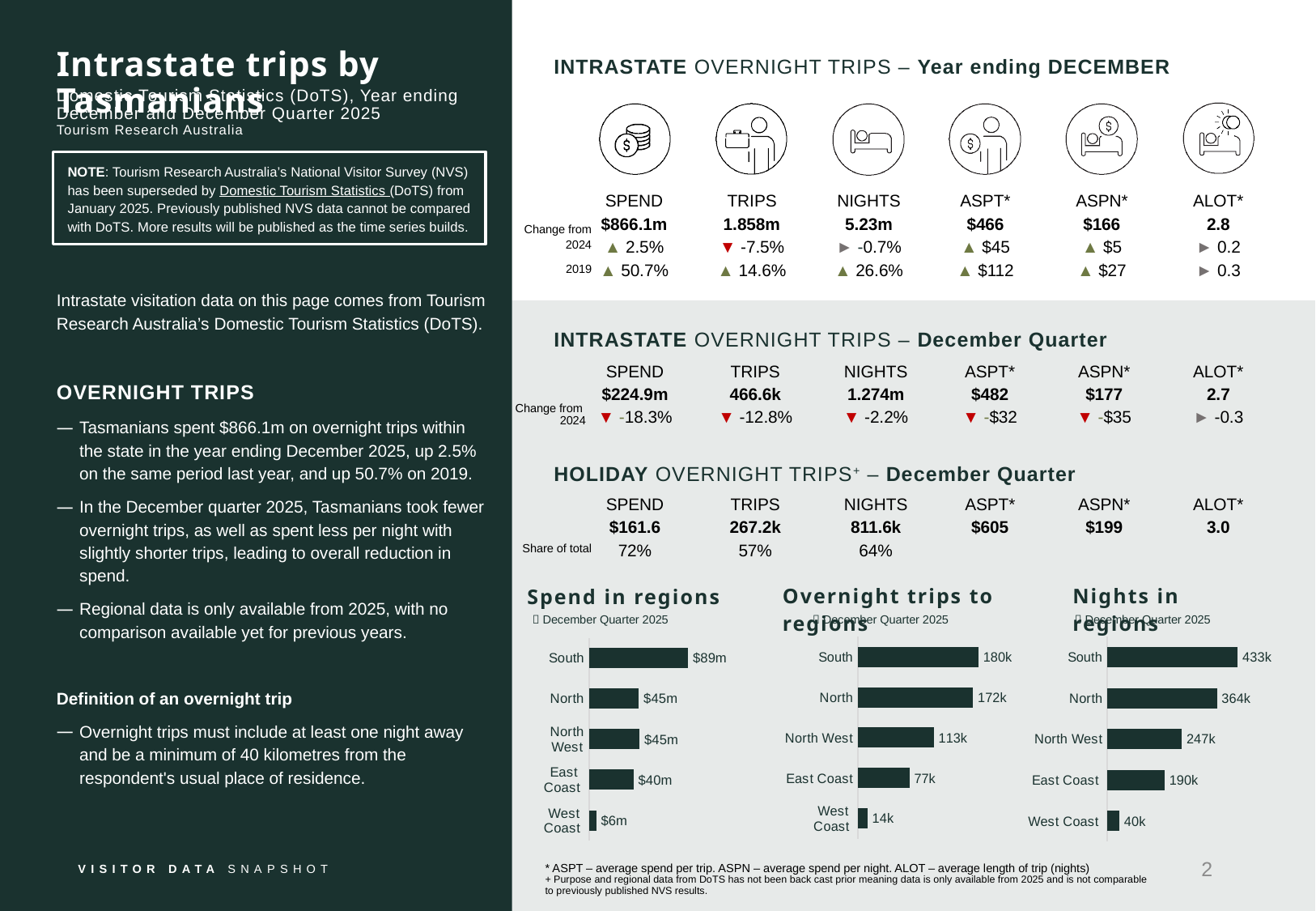
In the 'Nights in regions' chart, what is the difference between North and West Coast? 324k Which period do the three regional bar charts cover, according to their subtitles? December Quarter 2025 In the 'Spend in regions' chart, which region has the lowest spend? West Coast In the 'Overnight trips to regions' chart, which region has the highest number of trips? South How many regions are shown in the 'Spend in regions' chart? 5 In the 'Spend in regions' chart, what is the difference between South and East Coast? $49m What type of chart is the 'Nights in regions' chart? Bar chart In the 'Nights in regions' chart, which is larger, North or North West? North In the 'Spend in regions' chart, what is the value for South? $89m In the 'Overnight trips to regions' chart, what is the difference between South and North? 8k In the 'Overnight trips to regions' chart, what is the value for North West? 113k In the 'Nights in regions' chart, what is the value for East Coast? 190k